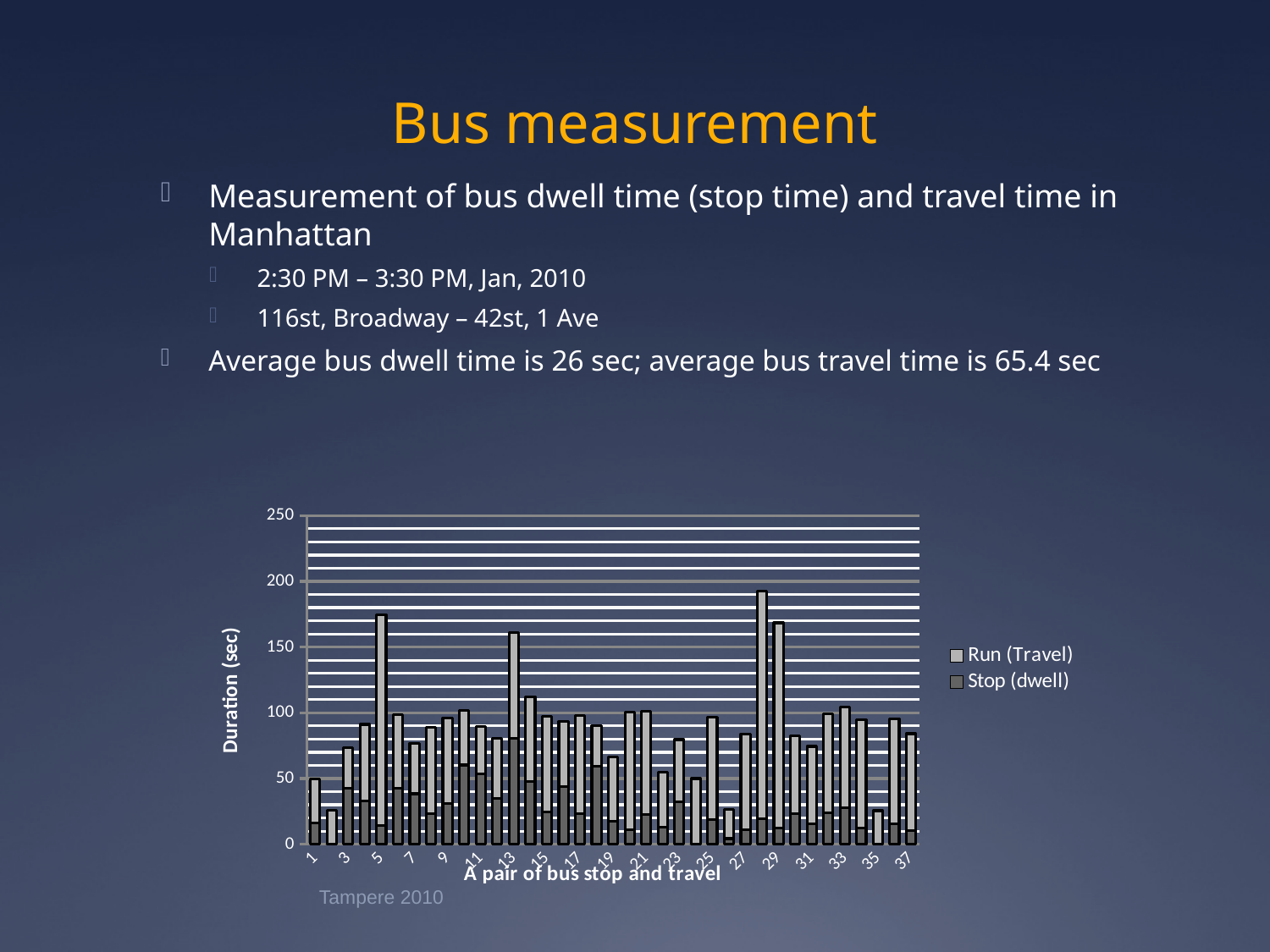
Is the total bar height for pair 3 greater or less than 50? greater Is the total bar height for pair 35 greater or less than 50? less What are the two series named in the chart legend? Run (Travel) and Stop (dwell) How many series does the chart legend list? 2 What is the title of the chart's vertical axis? Duration (sec) Is the total bar height for pair 7 greater or less than 100? less Which has the taller total bar, pair 29 or pair 35? pair 29 What kind of chart is shown on the slide? stacked bar chart Which has the taller total bar, pair 5 or pair 3? pair 5